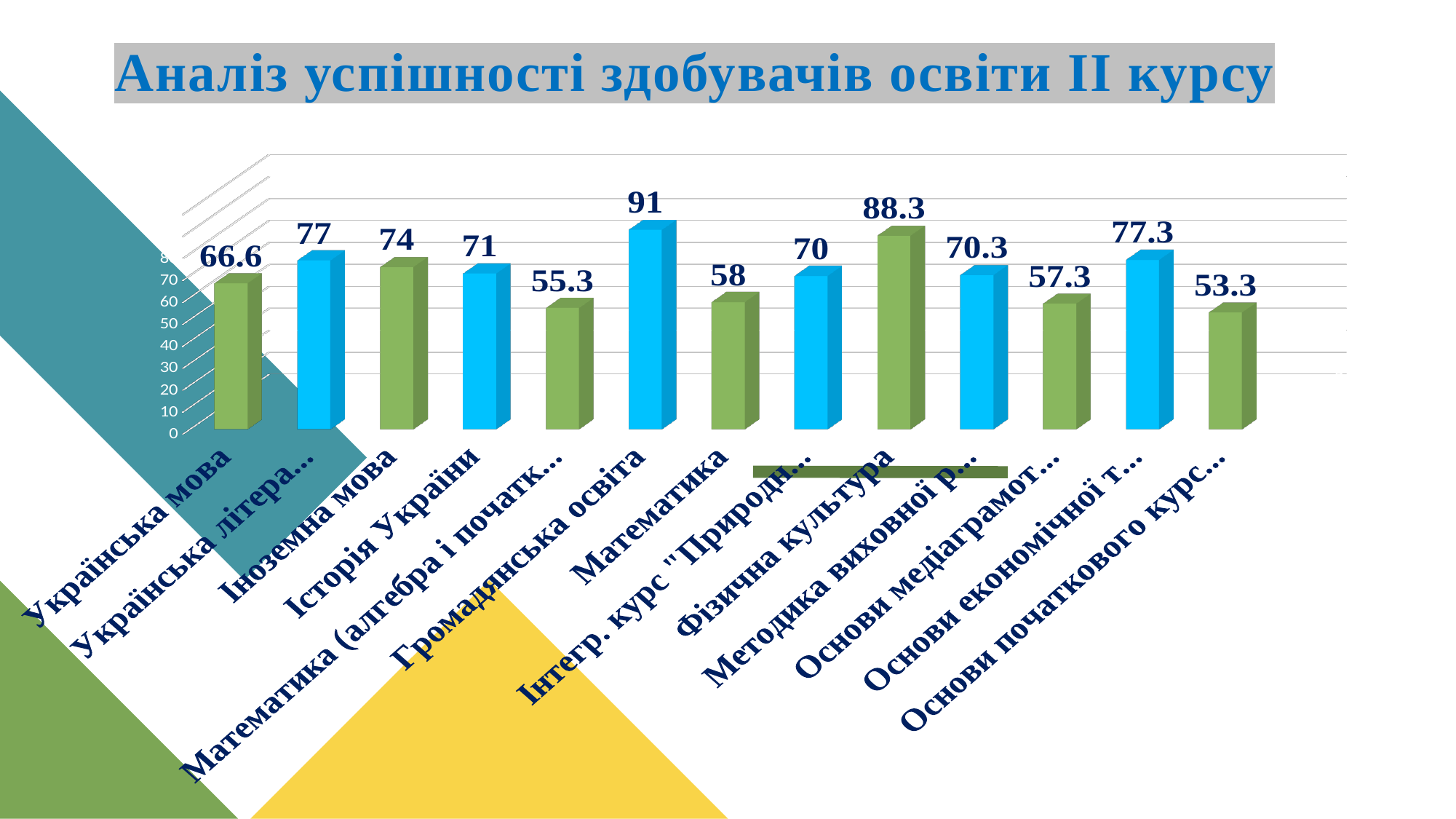
How many bars are shown on the chart? 13 Is the value for Математика greater or less than 60? less What is the value for Математика? 58 What is the lowest value shown on the chart? 53.3 Which category has the highest value? Громадянська освіта What is the value for Фізична культура? 88.3 What is the difference between the values for Громадянська освіта and Математика? 33 What is the value for Українська мова? 66.6 What kind of chart is shown on the slide? bar chart Which is larger, the value for Іноземна мова or the value for Історія України? Іноземна мова What is the value for Громадянська освіта? 91 What is the difference between the values for Фізична культура and Історія України? 17.3